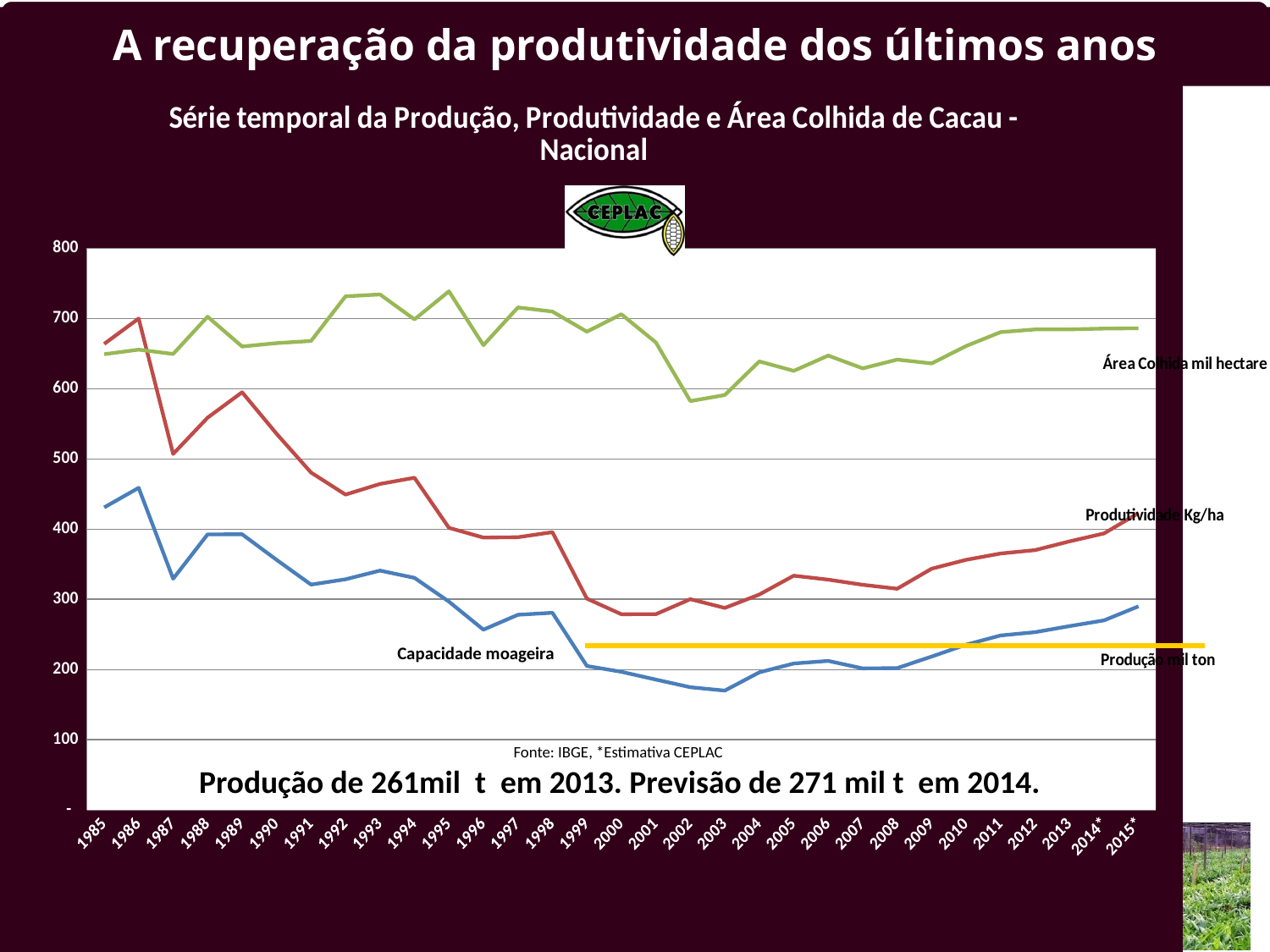
According to the text on the chart, what was the cocoa production (Produção) in 2013? 261mil t Is the value of Produção mil ton in 2003 greater or less than 200? less Is the value of Área Colhida mil hectare in 1995 greater or less than 700? greater Is the value of Produtividade Kg/ha in 2015* greater or less than 400? greater According to the text on the chart, what is the forecast production (Previsão) for 2014? 271 mil t What type of chart is shown on the slide? line chart Which of the two years has the larger Produtividade Kg/ha value: 1989 or 1995? 1989 Does the Produtividade Kg/ha series rise or fall from 2003 to 2015*? rise How many years are shown on the x axis? 31 By how much is the 2014 forecast production higher than the 2013 production, in mil t? 10